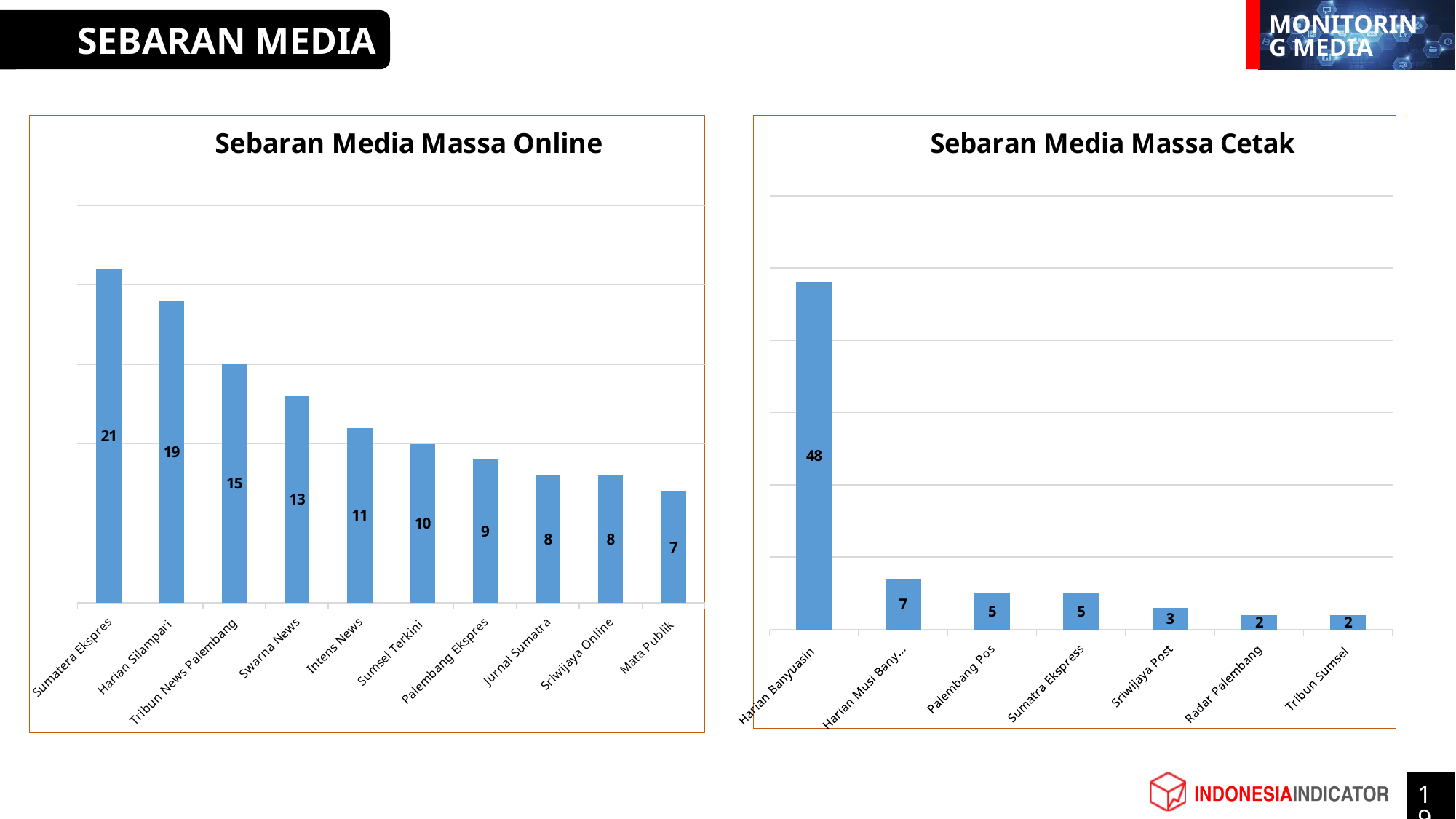
In the 'Sebaran Media Massa Cetak' chart, what is the value for Harian Banyuasin? 48 In the 'Sebaran Media Massa Online' chart, do the values rise or fall from left to right? fall In the 'Sebaran Media Massa Cetak' chart, how many categories are shown? 7 In the 'Sebaran Media Massa Cetak' chart, which category has the highest value? Harian Banyuasin In the 'Sebaran Media Massa Online' chart, what is the value for Swarna News? 13 In the 'Sebaran Media Massa Cetak' chart, which is larger: Palembang Pos or Radar Palembang? Palembang Pos In the 'Sebaran Media Massa Online' chart, what is the value for Sumatera Ekspres? 21 In the 'Sebaran Media Massa Online' chart, how many categories are shown? 10 In the 'Sebaran Media Massa Cetak' chart, what is the value for Sriwijaya Post? 3 What type of chart is 'Sebaran Media Massa Cetak'? bar chart In the 'Sebaran Media Massa Online' chart, what is the difference between Harian Silampari and Tribun News Palembang? 4 In the 'Sebaran Media Massa Online' chart, which category has the lowest value? Mata Publik